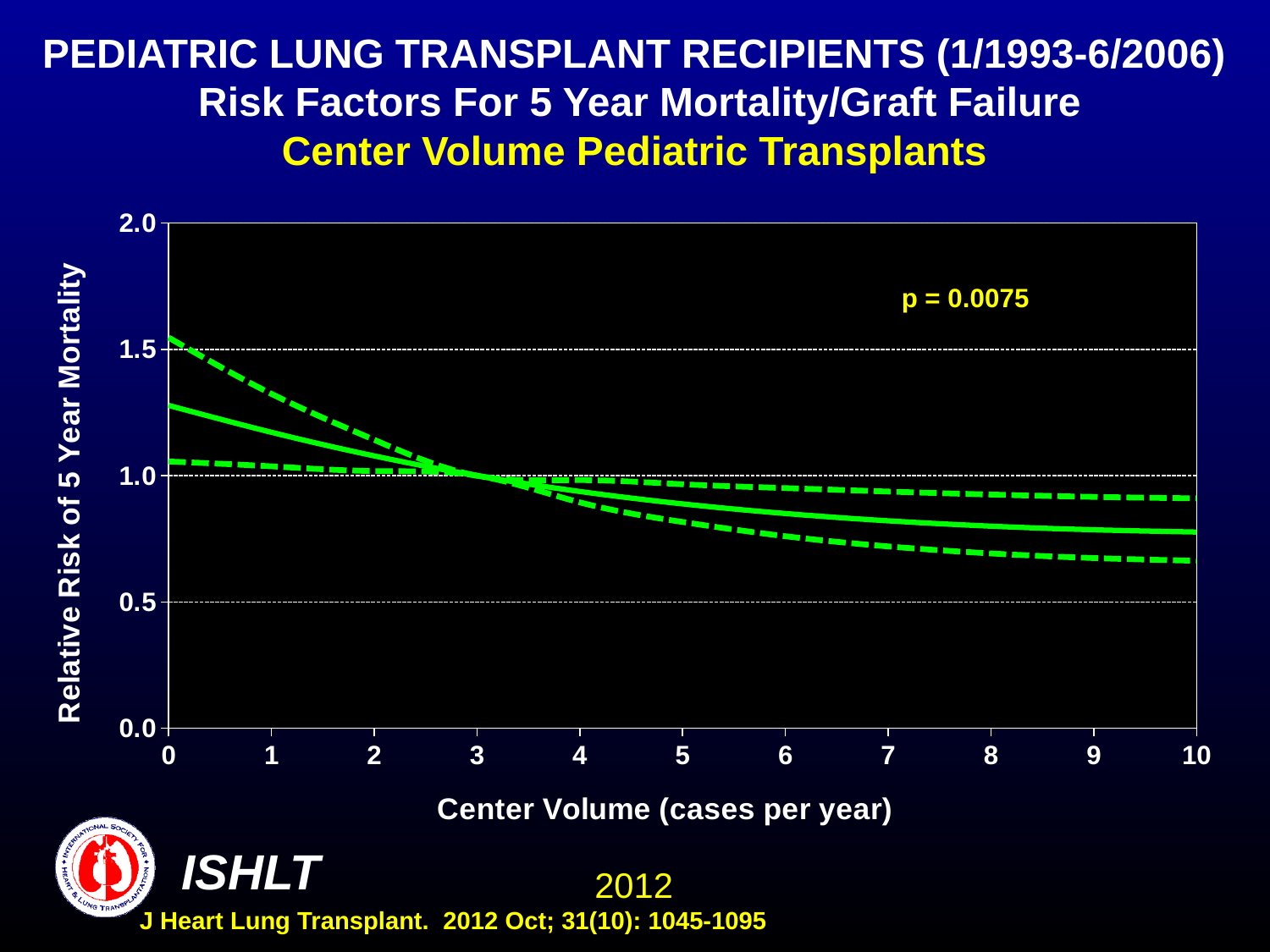
What is the highest center volume shown on the x axis? 10 What is the highest value shown on the y axis? 2.0 Does the solid line for relative risk rise or fall as center volume increases from 0 to 10 cases per year? fall What is the label of the x axis? Center Volume (cases per year) Is the relative risk shown by the solid line at a center volume of 10 cases per year greater or less than 0.5? greater What kind of chart is shown on the slide? line chart Is the lower dashed line at a center volume of 10 cases per year greater or less than 1.0? less What p-value is printed on the chart? p = 0.0075 Is the relative risk shown by the solid line at a center volume of 0 cases per year greater or less than 1.0? greater How many lines are plotted on the chart? 3